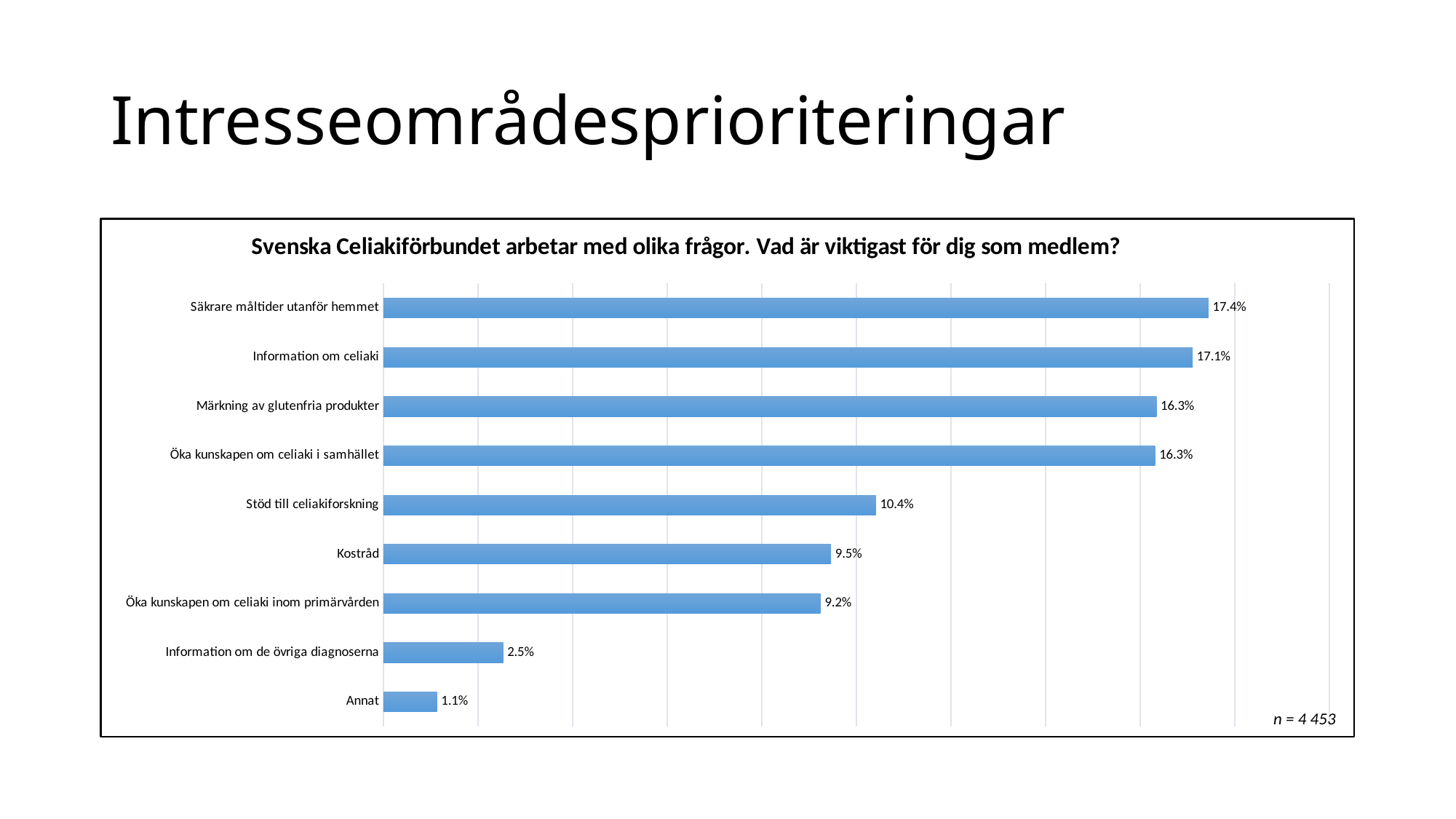
What is the value for Säkrare måltider utanför hemmet? 17.4% Which is larger, Kostråd or Öka kunskapen om celiaki inom primärvården? Kostråd What is the value for Kostråd? 9.5% What is the sample size (n) shown on the chart? n = 4 453 Which category has the highest value? Säkrare måltider utanför hemmet What is the value for Information om de övriga diagnoserna? 2.5% Which category has the lowest value? Annat What kind of chart is shown on the slide? Bar chart What is the difference between Stöd till celiakiforskning and Öka kunskapen om celiaki inom primärvården? 1.2% What is the value for Stöd till celiakiforskning? 10.4% How many categories are shown in the chart? 9 What is the difference between Säkrare måltider utanför hemmet and Information om celiaki? 0.3%